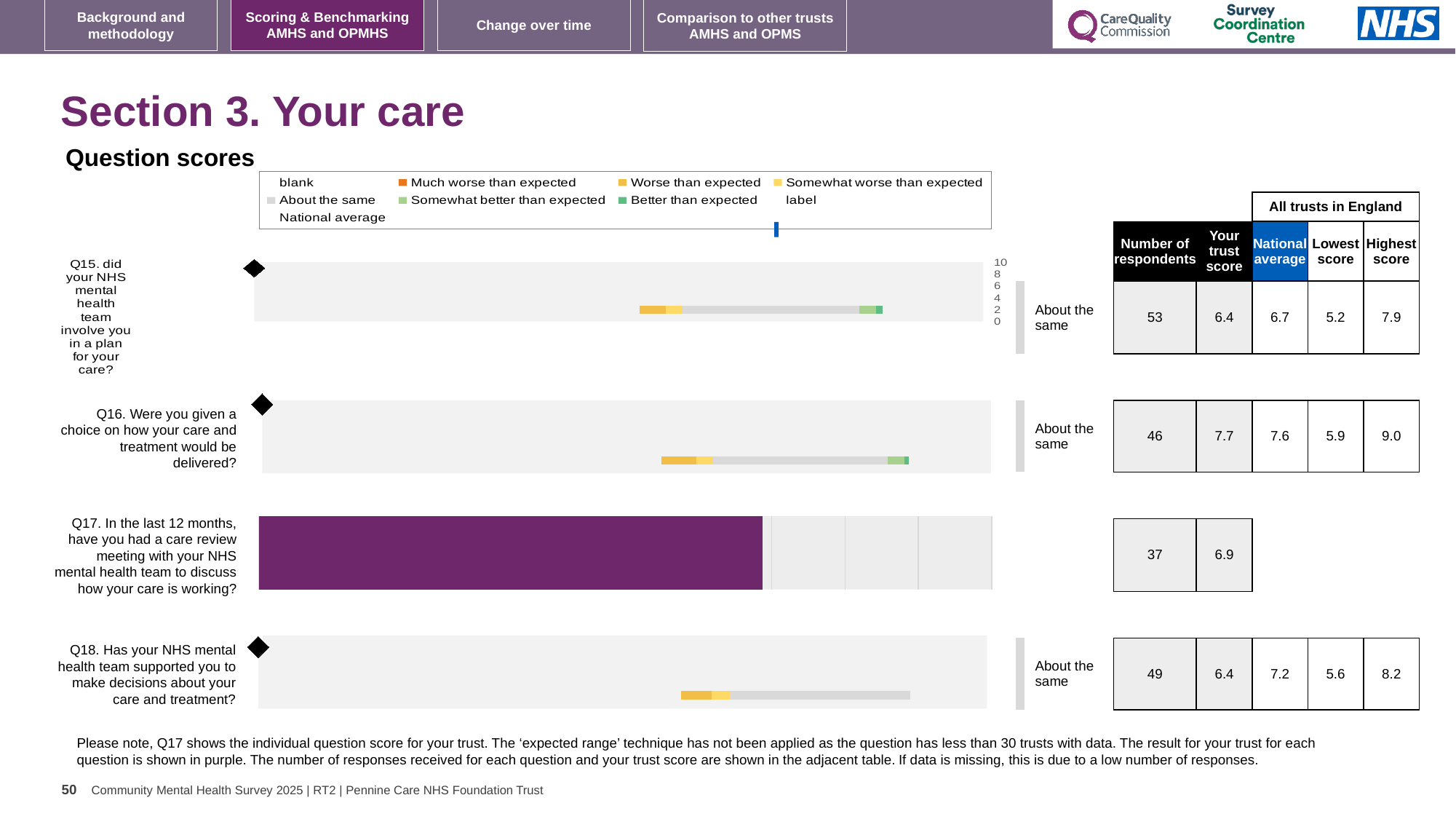
What colour is the bar for Q17 in the chart? Purple What kind of chart is used to show the question scores? Bar chart Which question has the lowest number of respondents? Q17 How many questions are plotted in the Question scores chart? 4 What label is shown beside the Q18 bar describing how the trust compares to expected? About the same Which question has the highest trust score? Q16 For Q15, which is larger: the trust score or the national average? National average What is the national average for Q18? 7.2 What is the trust score for Q16 (Were you given a choice on how your care and treatment would be delivered)? 7.7 What is the highest score among all trusts in England for Q16? 9.0 What is the difference between the highest score and the lowest score for Q16? 3.1 What is the number of respondents for Q15 in the table next to the chart? 53